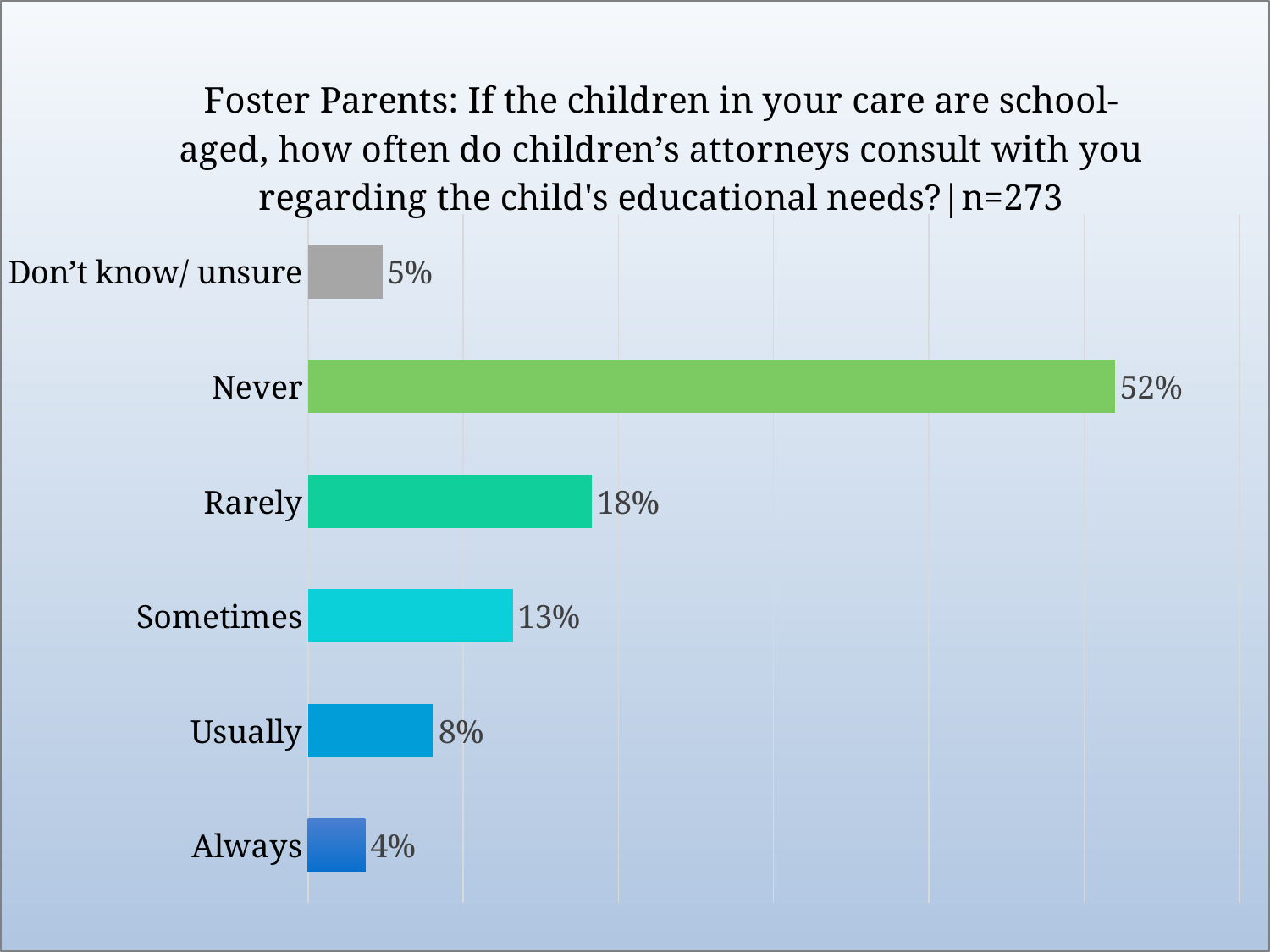
Which response category has the lowest value? Always What is the difference between the values for "Usually" and "Always"? 4% Which response category has the highest value? Never What is the difference between the values for "Never" and "Rarely"? 34% What kind of chart is shown on the slide? Bar chart What percentage of foster parents answered "Never"? 52% How many response categories are shown in the chart? 6 What percentage of respondents answered "Sometimes"? 13% What is the value for "Don't know/ unsure"? 5% What is the value for "Rarely"? 18% What is the sample size (n) stated in the chart title? 273 Which is larger, the value for "Sometimes" or the value for "Usually"? Sometimes